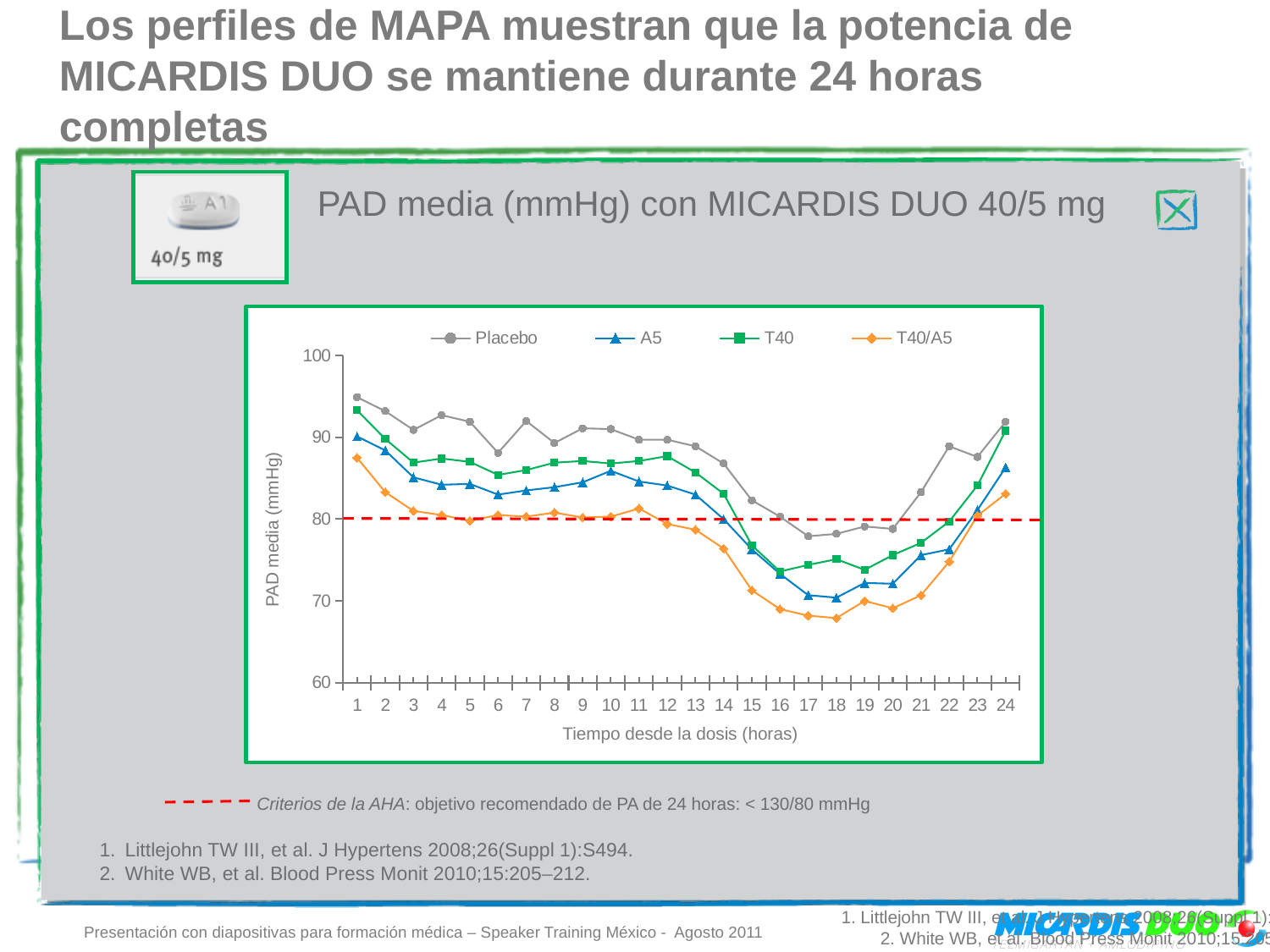
Which series has the lowest value at hour 17? T40/A5 Does the Placebo series rise or fall from hour 12 to hour 17? fall What kind of chart is shown on the slide? line chart How many time points (hours) are plotted along the x axis? 24 Which series has the highest value at hour 1? Placebo Is the A5 value at hour 16 greater or less than 80? less Is the T40/A5 value at hour 18 greater or less than 70? less At hour 1, which is higher: Placebo or T40/A5? Placebo At what PAD value is the dashed red reference line drawn? 80 How many series does the chart legend list? 4 What are the four series named in the legend? Placebo, A5, T40, T40/A5 Is the Placebo value at hour 1 greater or less than 90? greater